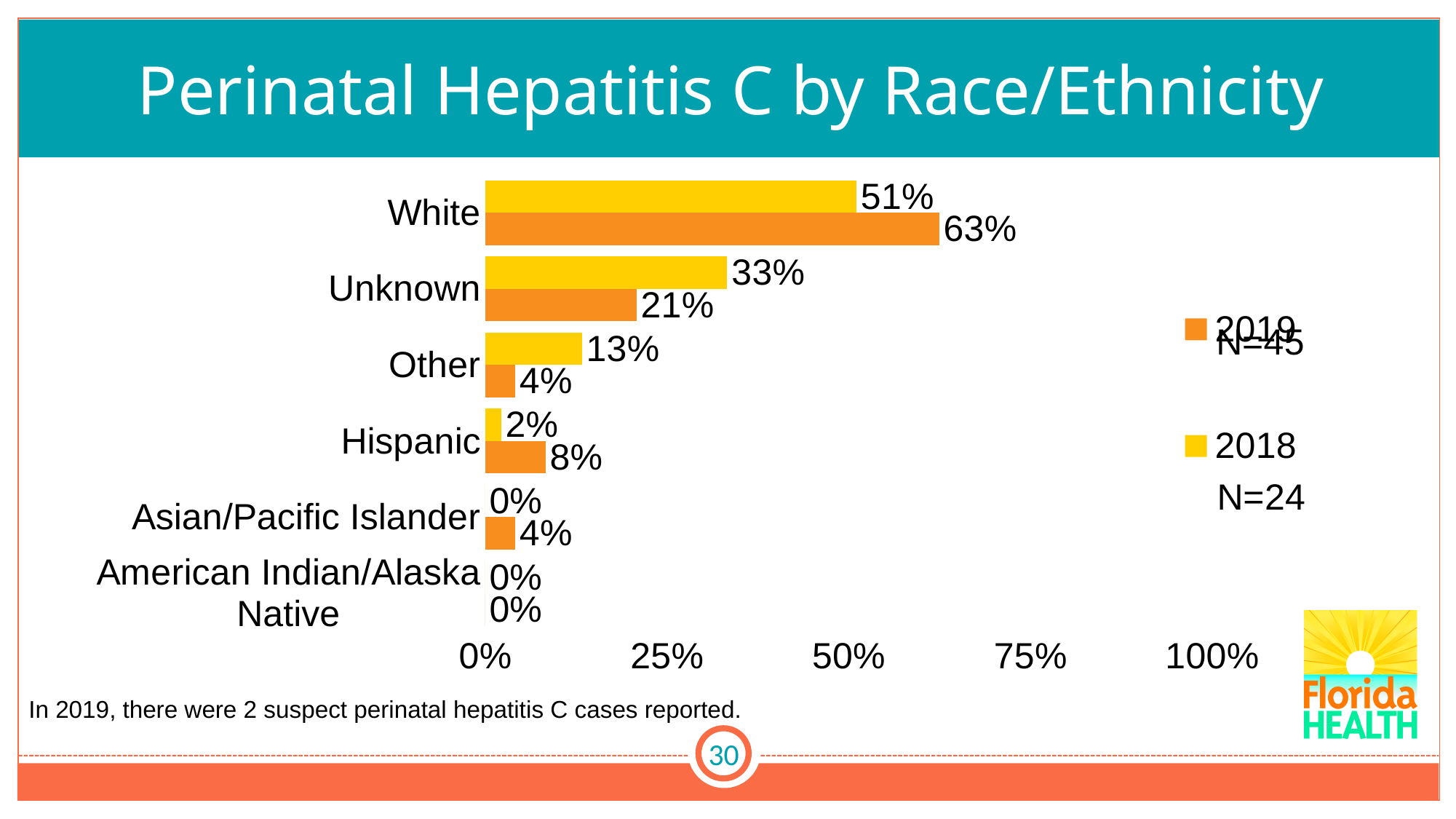
What is the difference between the 2018 and 2019 values for Unknown? 12% Which is larger for Hispanic, the 2018 value or the 2019 value? 2019 Which race/ethnicity category has the lowest 2019 value? American Indian/Alaska Native What is the 2018 value for Unknown? 33% What is the 2018 value for Other? 13% What is the difference between the 2019 and 2018 values for White? 12% What is the 2019 value for White? 63% How many series does the legend list? 2 What kind of chart is shown on the slide? Bar chart What is the 2019 value for Hispanic? 8% Which race/ethnicity category has the highest 2019 value? White How many race/ethnicity categories are shown on the chart? 6